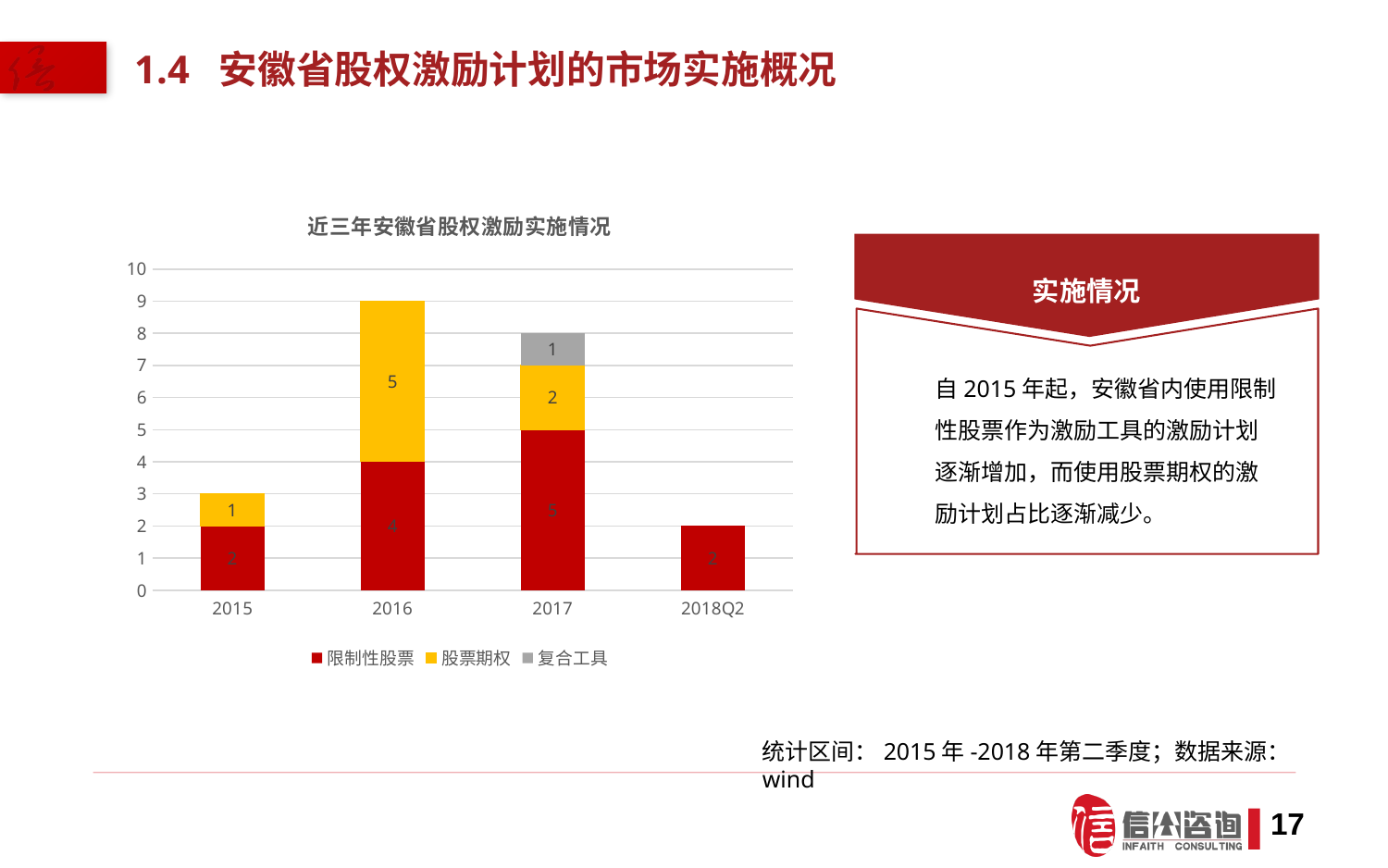
What is the value for 股票期权 in 2017? 2 Which is larger, the 限制性股票 value in 2015 or in 2016? 2016 What is the value for 限制性股票 in 2016? 4 How many categories are shown on the x axis of the chart? 4 What is the total of the stacked bar for 2016? 9 Which year has the highest value for 限制性股票? 2017 What type of chart is shown on the slide? Stacked bar chart What is the total of the stacked bar for 2017? 8 How many series does the chart legend list? 3 What is the difference between the 股票期权 values for 2016 and 2017? 3 What is the value for 复合工具 in 2017? 1 What is the title of the chart? 近三年安徽省股权激励实施情况